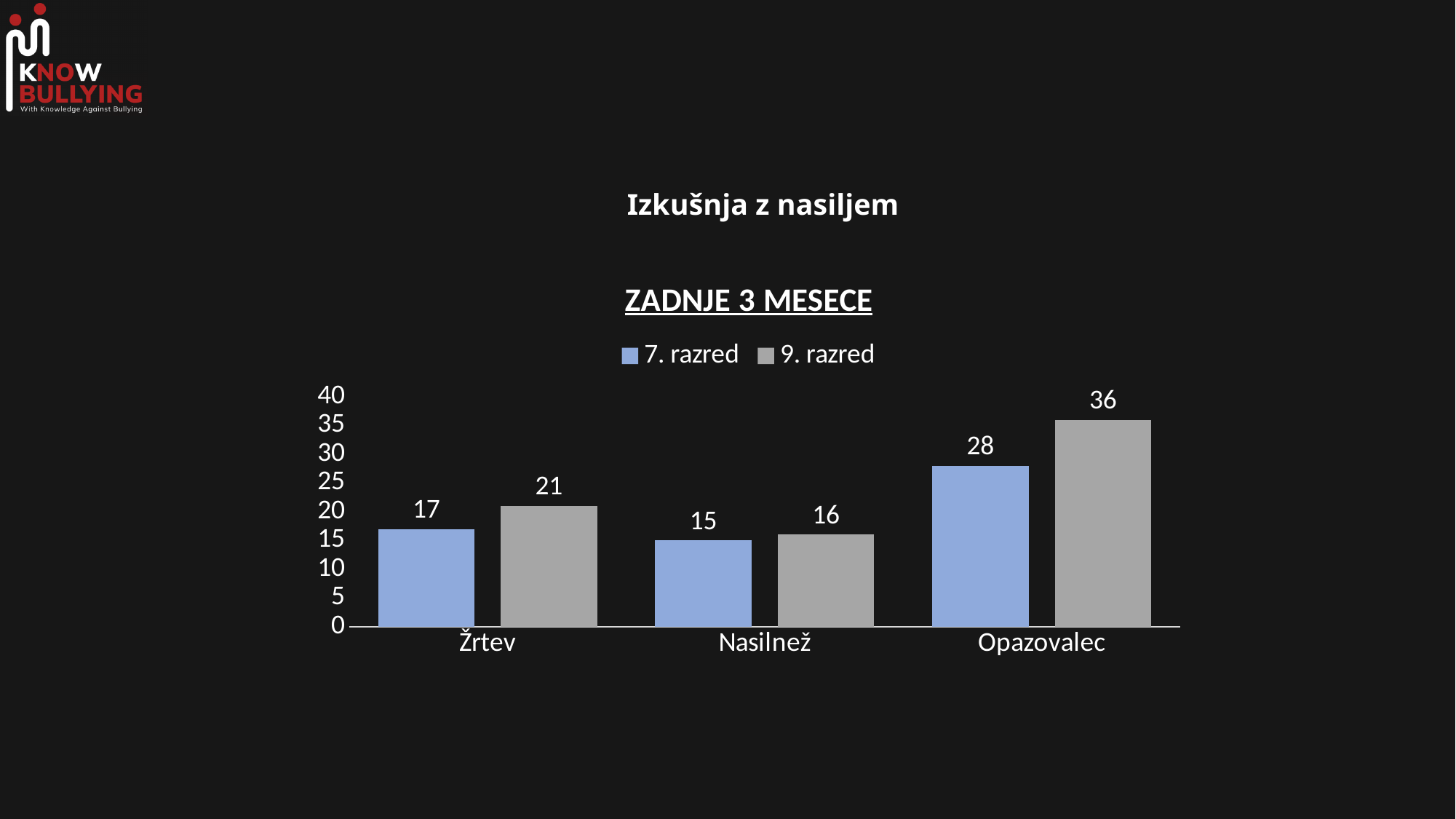
What is the difference between the 9. razred and 7. razred values for Opazovalec? 8 What is the difference between the 9. razred and 7. razred values for Žrtev? 4 What is the value for 9. razred in the Nasilnež category? 16 How many categories are shown on the x axis? 3 How many series does the legend list? 2 Which category has the lowest value for 7. razred? Nasilnež What is the value for 9. razred in the Opazovalec category? 36 What is the value for 7. razred in the Žrtev category? 17 Which category has the highest value for 9. razred? Opazovalec What is the underlined chart title shown above the legend? ZADNJE 3 MESECE What kind of chart is shown on the slide? Bar chart Which is larger for Opazovalec: the 7. razred value or the 9. razred value? 9. razred